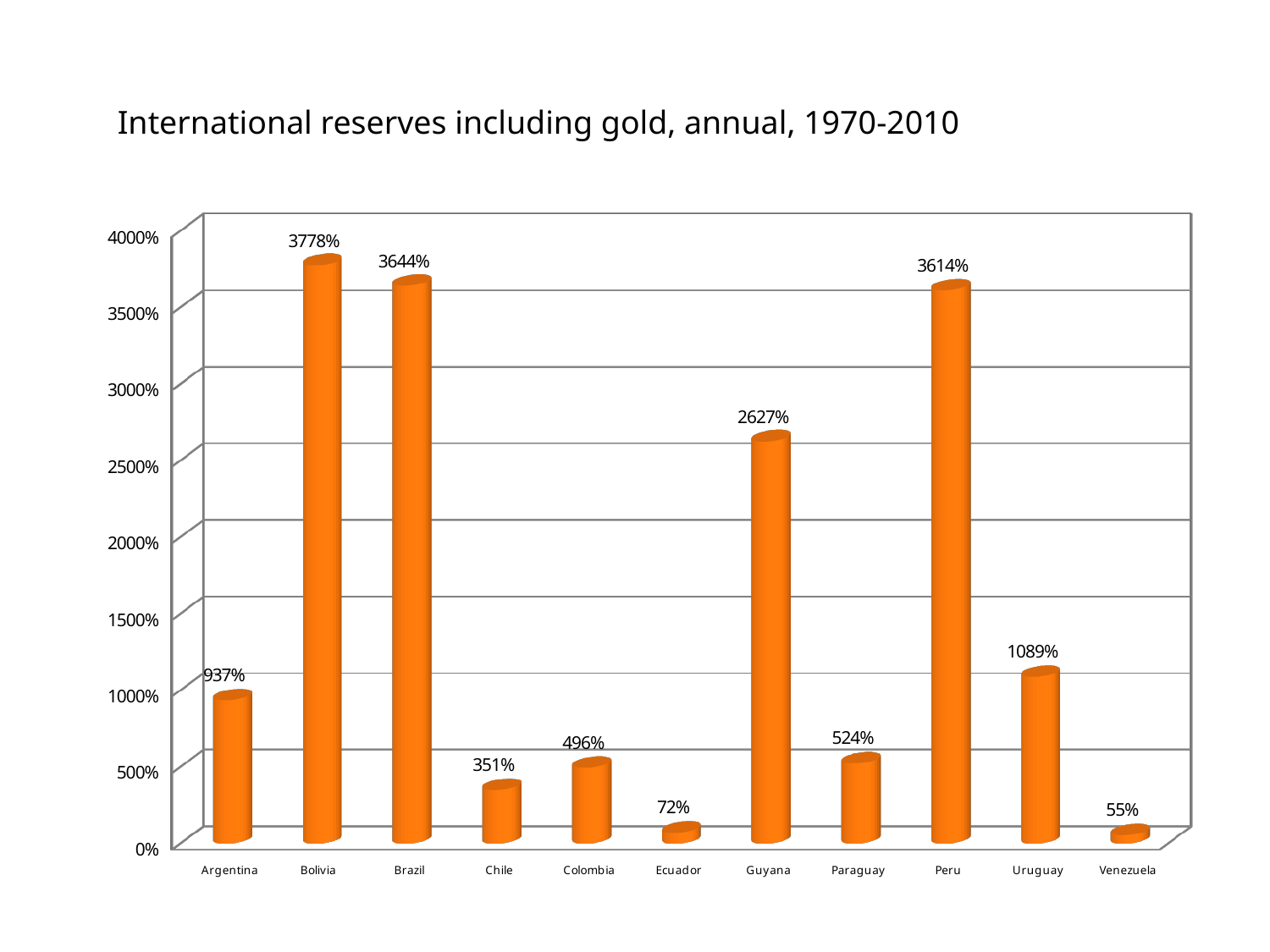
What kind of chart is shown on the slide? bar chart Is the value for Peru greater or less than 3500%? greater What is the value for Guyana? 2627% What is the value for Bolivia? 3778% What is the title of the chart? International reserves including gold, annual, 1970-2010 What is the difference between the values for Uruguay and Argentina? 152% What is the value for Venezuela? 55% Which is larger, the value for Colombia or the value for Paraguay? Paraguay Which country has the lowest value? Venezuela What is the difference between the values for Bolivia and Brazil? 134% Which country has the highest value? Bolivia How many countries are shown on the chart? 11